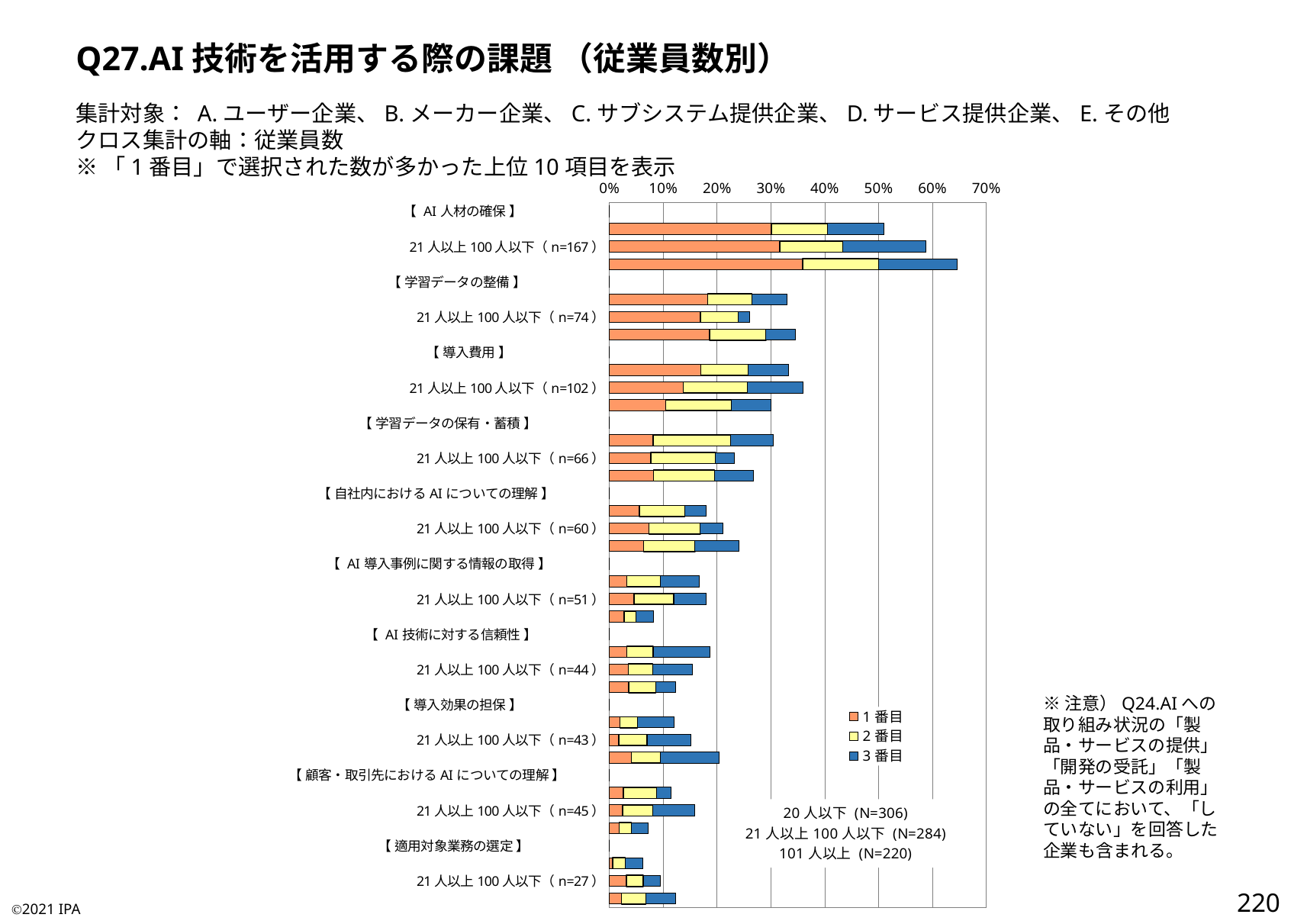
How many series does the legend list? 3 What are the three series named in the legend? 1番目, 2番目, 3番目 How many challenge items (bracketed categories) are shown on the chart? 10 Which is larger: the 21人以上100人以下 bar for AI人材の確保 or the 21人以上100人以下 bar for 学習データの整備? AI人材の確保 Is the total value of the 21人以上100人以下 bar for 導入費用 greater or less than 30%? greater Among the 21人以上100人以下 bars, which challenge item has the shortest bar? 適用対象業務の選定 What is the n value shown for 21人以上100人以下 under AI人材の確保? n=167 Is the total value of the 21人以上100人以下 bar for AI人材の確保 greater or less than 50%? greater What kind of chart is shown on the slide? stacked bar chart Which challenge item has the longest bars overall? AI人材の確保 Is the total value of the 21人以上100人以下 bar for 学習データの整備 greater or less than 30%? less